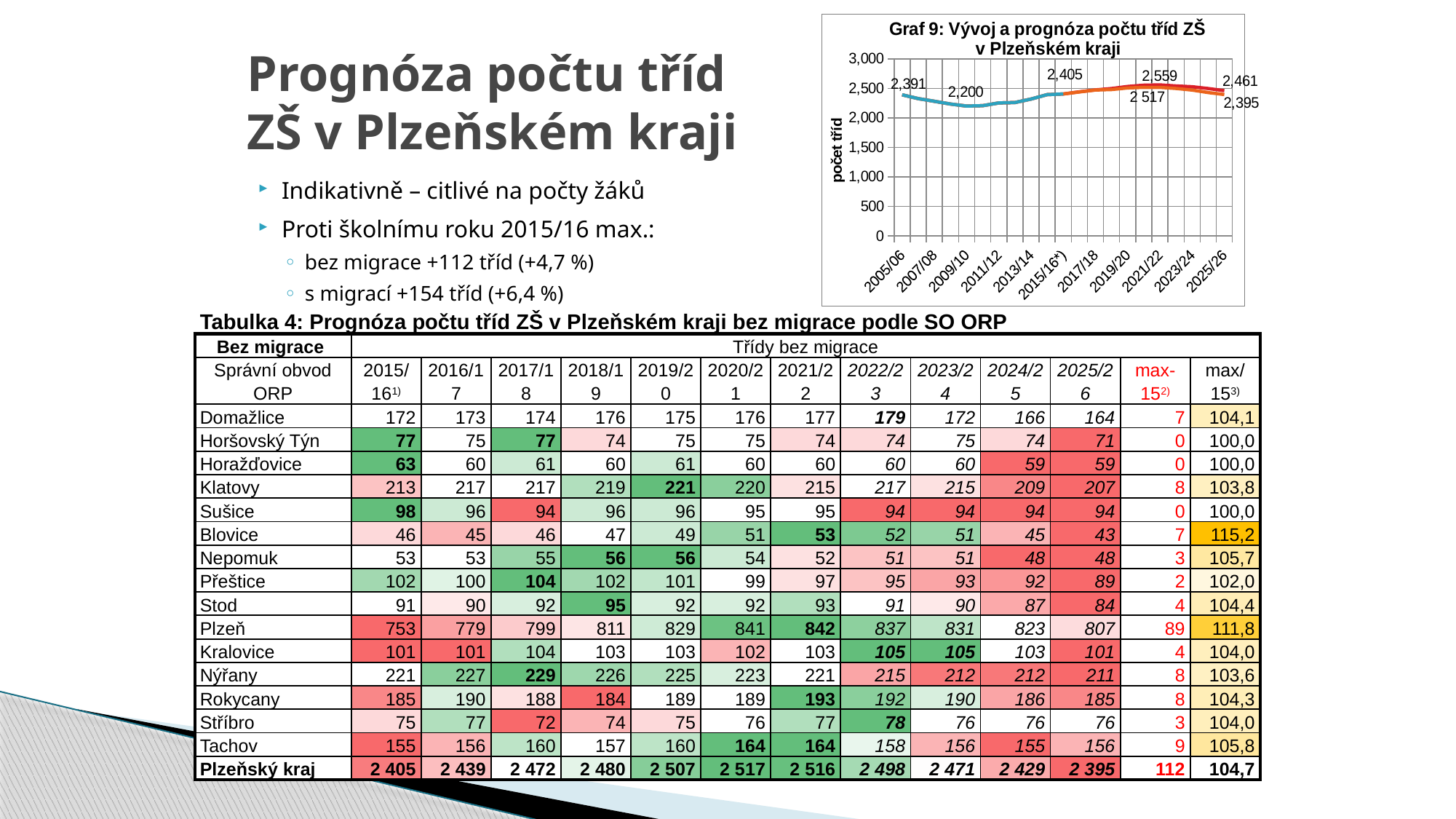
In Graf 9, does the line rise or fall between 2005/06 and 2009/10? fall What is the highest tick value on the y-axis of Graf 9? 3,000 In Graf 9, which is larger: the value for 2005/06 or the value around 2009/10? 2005/06 In Graf 9, what is the difference between the labelled values 2,405 (2015/16*) and 2,391 (2005/06)? 14 In Graf 9, what is the difference between the two labelled values at 2025/26, 2,461 and 2,395? 66 In Graf 9, what is the labelled value for 2005/06? 2,391 In Graf 9, what is the lowest labelled value on the line? 2,200 In Graf 9, what is the highest labelled value shown? 2,559 In Graf 9, is the value around 2009/10 greater or less than 2,500? less In Graf 9, what is the labelled value for 2015/16*)? 2,405 What is the y-axis title of Graf 9? počet tříd What kind of chart is Graf 9 on the slide? line chart